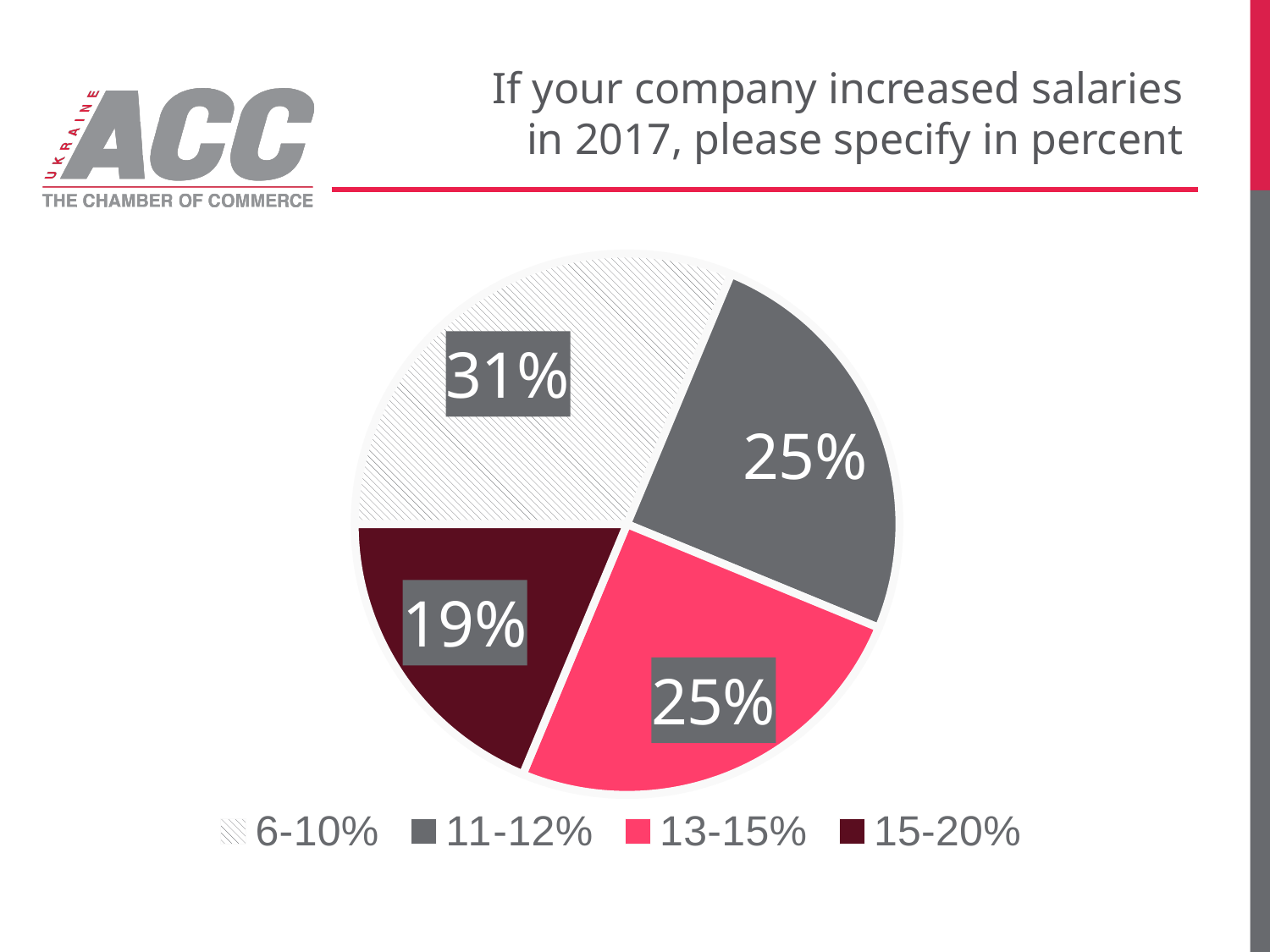
What is the difference between the shares of the 6-10% and 15-20% categories? 12% Which category has the smallest share of the pie? 15-20% Which is larger, the share for 6-10% or the share for 11-12%? 6-10% How many categories does the pie chart have? 4 How many entries does the legend list? 4 What share of the pie does the 11-12% category have? 25% What kind of chart is shown on the slide? pie chart What is the title of the chart? If your company increased salaries in 2017, please specify in percent What share of the pie does the 6-10% category have? 31% What share of the pie does the 15-20% category have? 19% Which category has the largest share of the pie? 6-10%